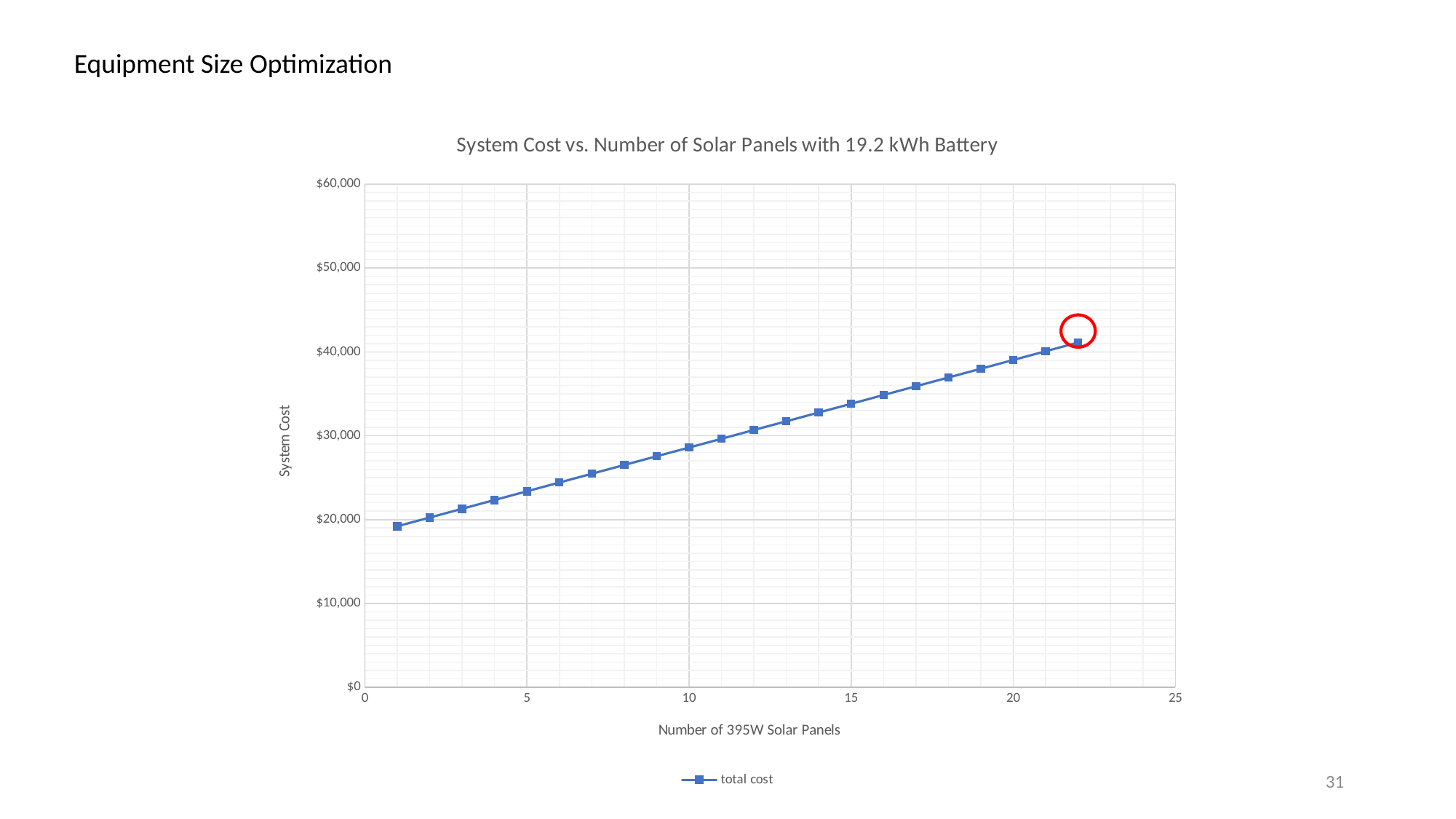
Is the total cost for 22 solar panels greater or less than $40,000? greater Is the total cost for 1 solar panel greater or less than $20,000? less Does the total cost rise or fall as the number of solar panels increases? rise At which number of solar panels is the total cost highest? 22 Is the total cost for 10 solar panels greater or less than $30,000? less What kind of chart is shown on the slide? line chart Which has a higher total cost: 5 solar panels or 15 solar panels? 15 solar panels How many data points are plotted on the chart? 22 What is the name of the series in the legend? total cost How many series does the legend list? 1 At which number of solar panels is the total cost lowest? 1 What is the title of the chart? System Cost vs. Number of Solar Panels with 19.2 kWh Battery